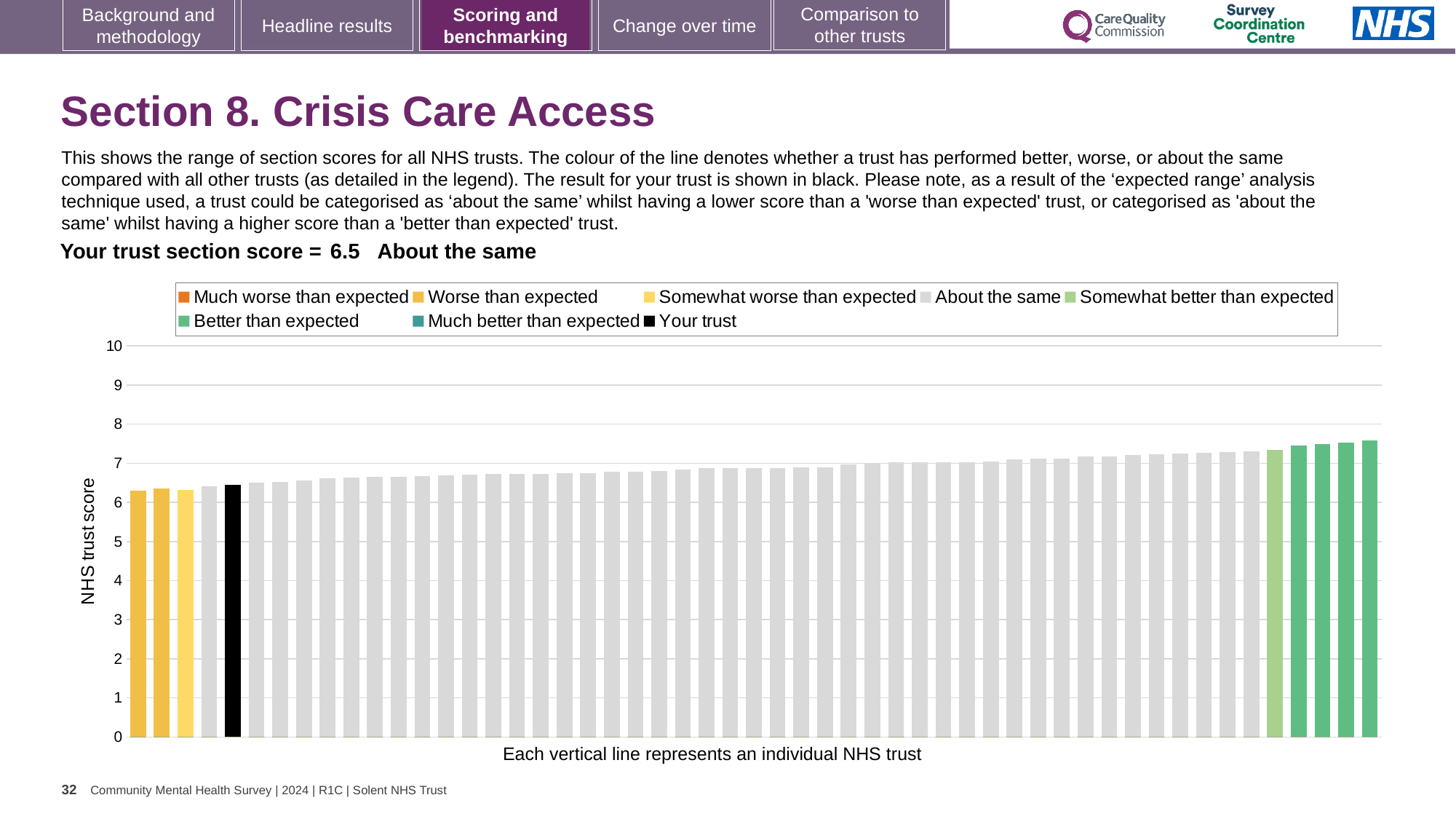
What is the section score for your trust shown on the slide? 6.5 Which category is your trust's section score placed in? About the same Is the value for the rightmost bar greater or less than 7? greater Is the value for the highest bar greater or less than 8? less What kind of chart is shown on the slide? bar chart What is the label of the y axis? NHS trust score Do the bar values rise or fall from left to right along the x axis? rise How many series does the legend list? 8 Is the value for your trust (the black bar) greater or less than 6? greater How many bars are coloured as 'Worse than expected'? 2 How many bars are coloured as 'Better than expected'? 4